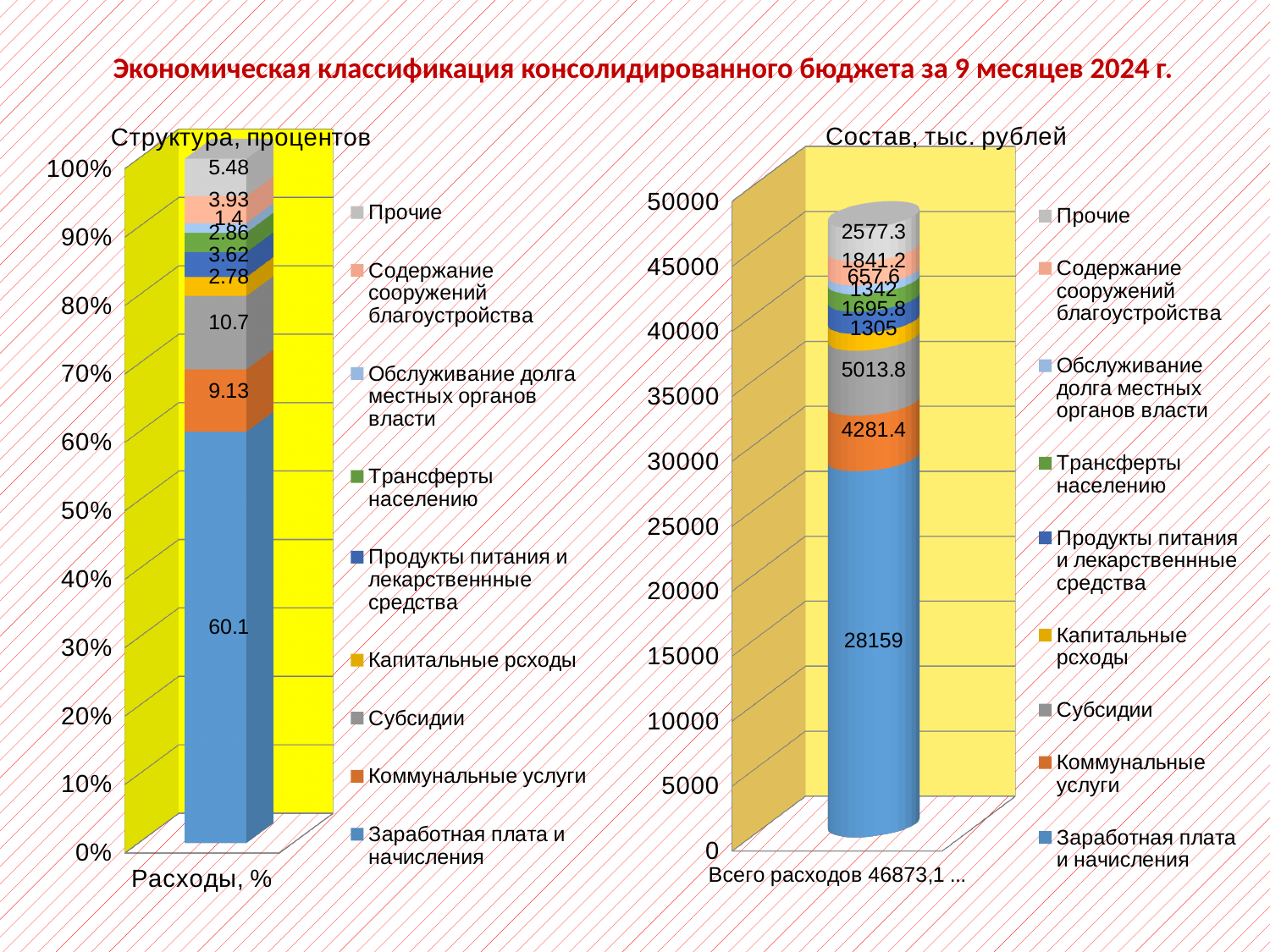
In the chart titled "Состав, тыс. рублей", what is the difference between the values for "Субсидии" and "Коммунальные услуги"? 732.4 In the chart titled "Состав, тыс. рублей", what is the value for "Коммунальные услуги"? 4281.4 In the chart titled "Состав, тыс. рублей", what is the value for "Прочие"? 2577.3 In the chart titled "Состав, тыс. рублей", which series has the highest value? Заработная плата и начисления In the chart titled "Структура, процентов", which series has the lowest value? Обслуживание долга местных органов власти In the chart titled "Структура, процентов", what is the value for "Субсидии"? 10.7 How many series does the legend of the chart titled "Состав, тыс. рублей" list? 9 In the chart titled "Структура, процентов", what is the difference between the values for "Прочие" and "Содержание сооружений благоустройства"? 1.55 In the chart titled "Структура, процентов", what is the value for "Заработная плата и начисления"? 60.1 What kind of chart is the chart titled "Структура, процентов"? Stacked bar chart In the chart titled "Состав, тыс. рублей", what is the total of the stacked bar? 46873.1 In the chart titled "Структура, процентов", which is larger: the value for "Продукты питания и лекарственнные средства" or the value for "Трансферты населению"? Продукты питания и лекарственнные средства